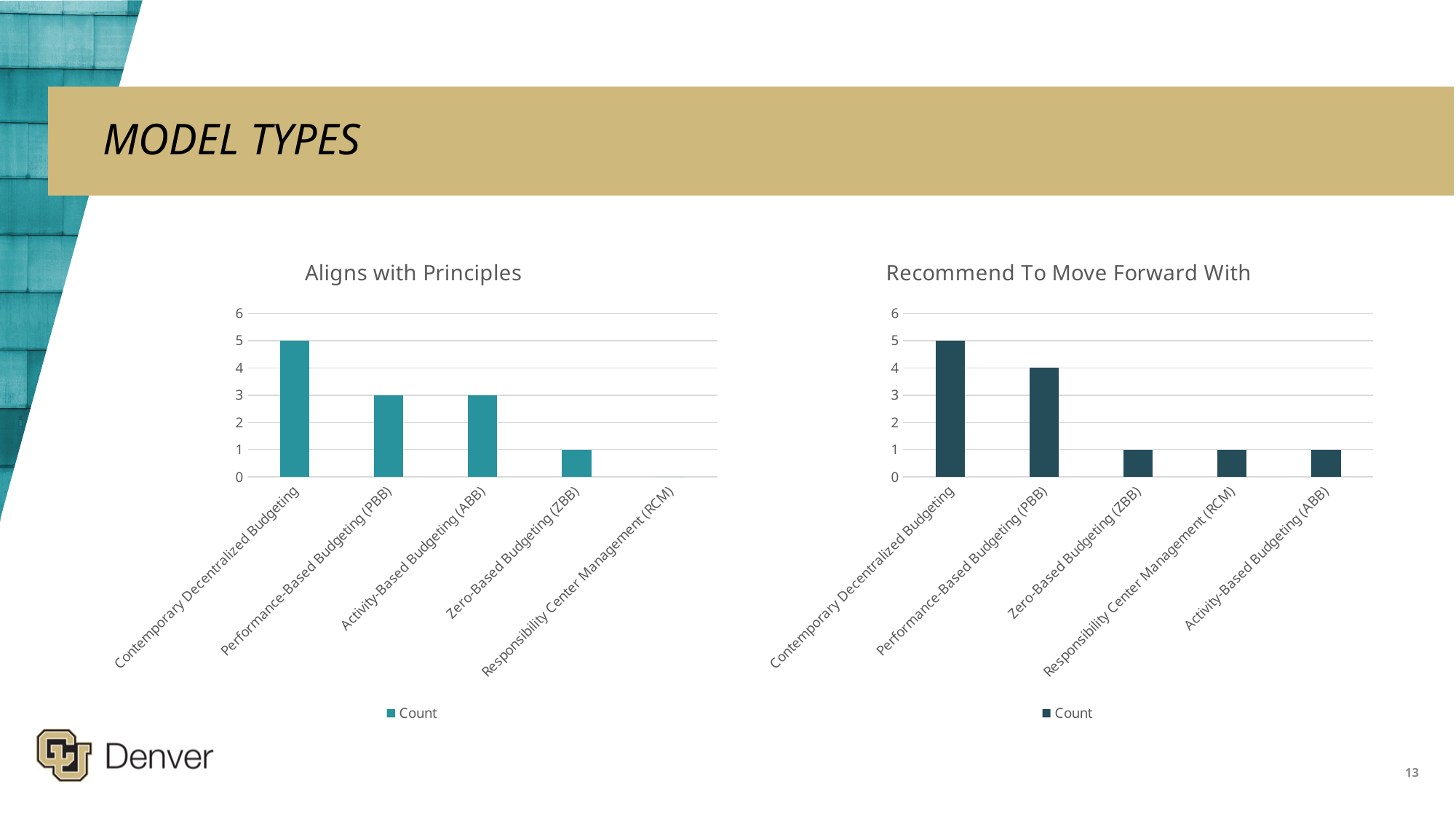
What kind of chart is the 'Recommend To Move Forward With' chart? Bar chart What is the legend entry shown under the 'Recommend To Move Forward With' chart? Count In the 'Aligns with Principles' chart, which category has the lowest count? Responsibility Center Management (RCM) In the 'Aligns with Principles' chart, which has a larger count: Performance-Based Budgeting (PBB) or Zero-Based Budgeting (ZBB)? Performance-Based Budgeting (PBB) In the 'Recommend To Move Forward With' chart, what is the difference between the counts for Contemporary Decentralized Budgeting and Performance-Based Budgeting (PBB)? 1 In the 'Recommend To Move Forward With' chart, which category has the highest count? Contemporary Decentralized Budgeting In the 'Aligns with Principles' chart, what is the count for Zero-Based Budgeting (ZBB)? 1 In the 'Aligns with Principles' chart, what is the count for Contemporary Decentralized Budgeting? 5 In the 'Recommend To Move Forward With' chart, what is the count for Performance-Based Budgeting (PBB)? 4 In the 'Aligns with Principles' chart, is the count for Activity-Based Budgeting (ABB) greater or less than 2? greater How many categories are shown on the x axis of the 'Recommend To Move Forward With' chart? 5 How many series does the legend of the 'Aligns with Principles' chart list? 1